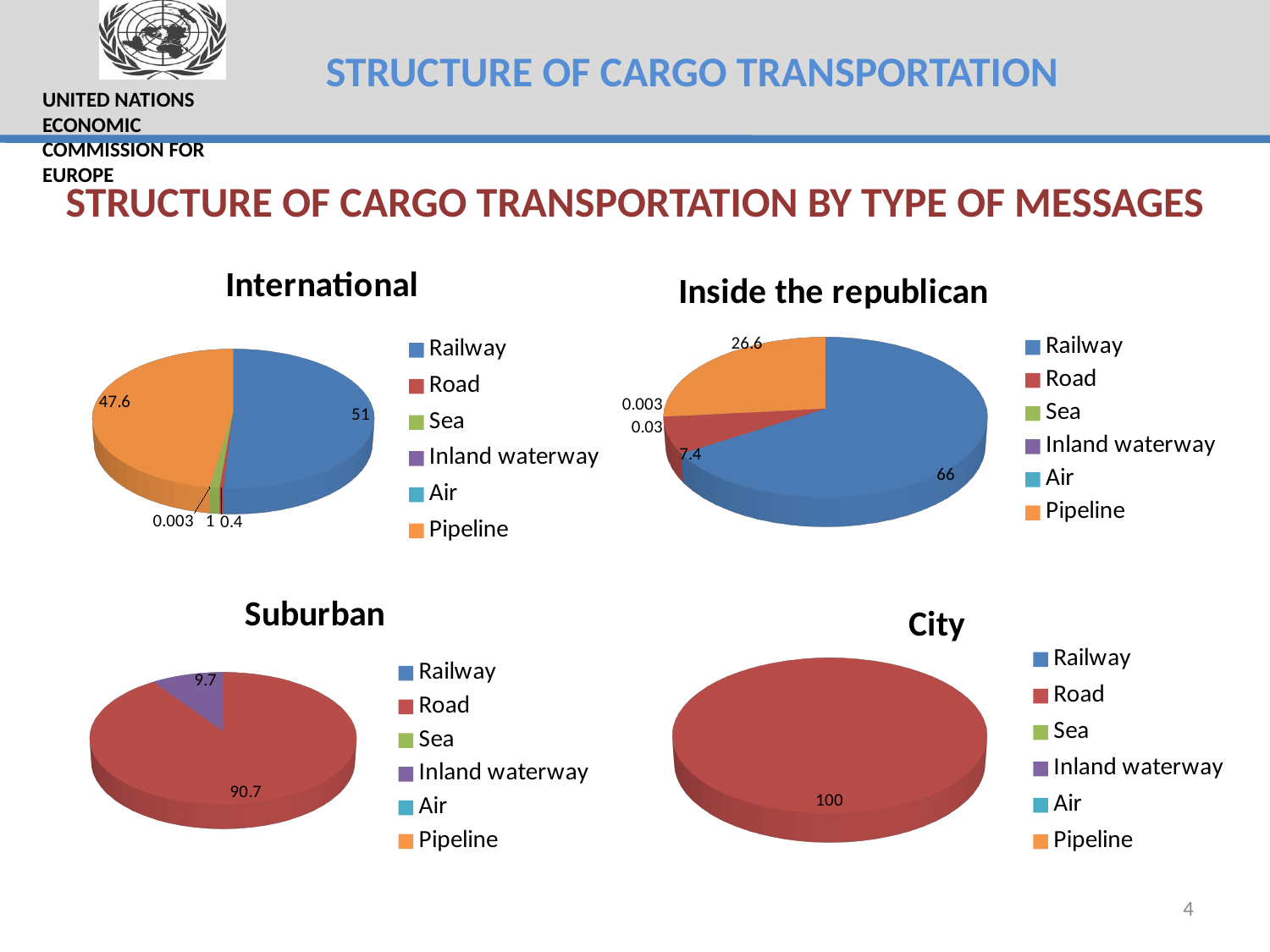
What kind of chart is the Suburban chart? Pie chart In the International chart, what is the difference between the Railway and Pipeline values? 3.4 In the Suburban chart, what value is shown for Inland waterway? 9.7 In the Inside the republican chart, what value is shown for Road? 7.4 In the International chart, what value is shown for Pipeline? 47.6 In the International chart, which category has the largest slice? Railway In the City chart, what value is shown for Road? 100 In the Inside the republican chart, which is larger, Road or Pipeline? Pipeline In the Inside the republican chart, what value is shown for Pipeline? 26.6 In the Suburban chart, what value is shown for Road? 90.7 In the International chart, what value is shown for Railway? 51 In the Inside the republican chart, what value is shown for Railway? 66